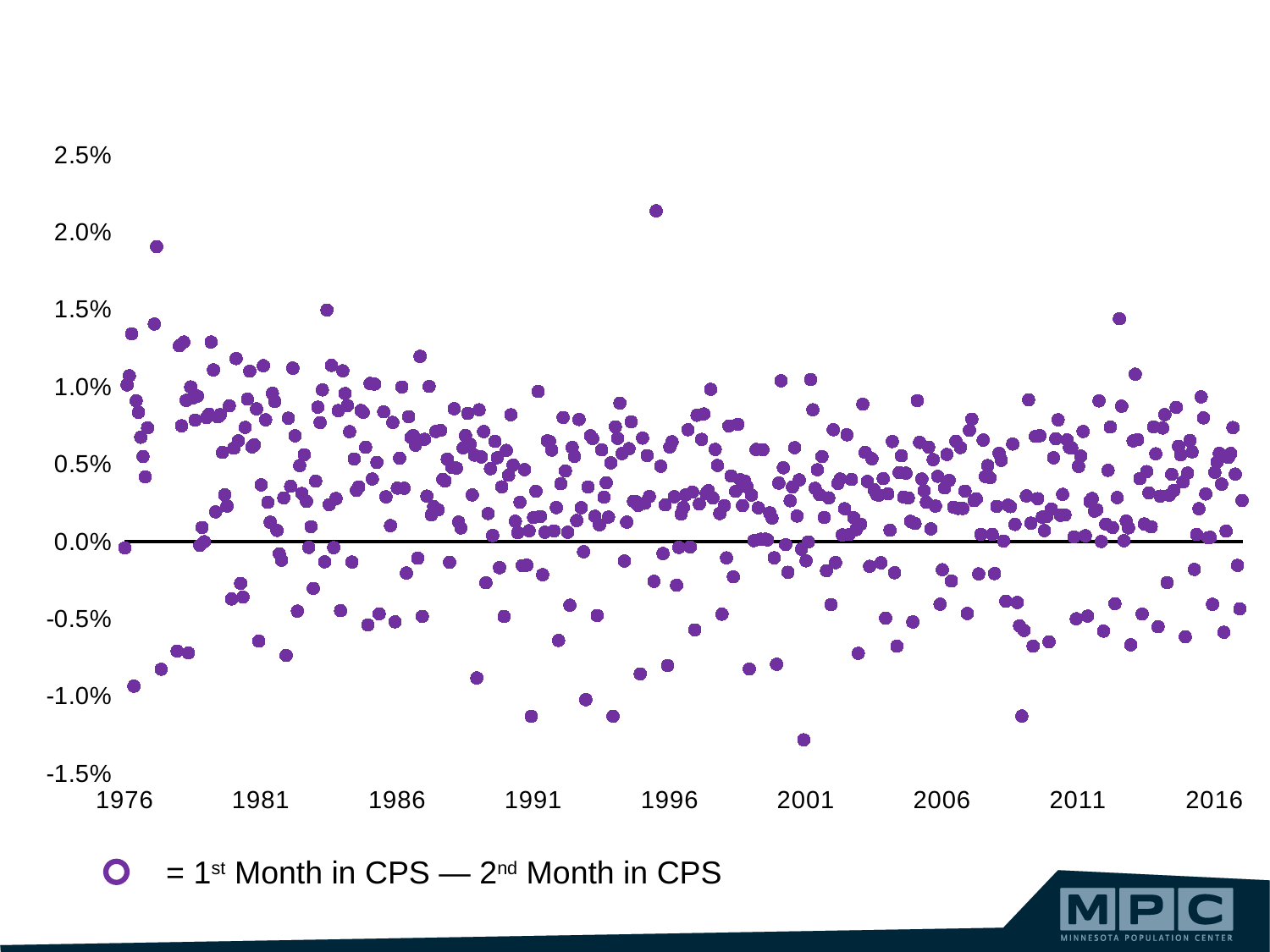
What are the first and last years labelled on the x axis? 1976 and 2016 Are most of the plotted points above or below the 0.0% line? above Is the low point near 2009 greater or less than -1.0%? less Is the low point near 1991 greater or less than -1.0%? less Is the highest point near 1995 higher or lower than the high point near 1977? higher Is the high point near 1977 greater or less than 1.5%? greater What does the legend say the plotted points represent? 1st Month in CPS — 2nd Month in CPS What kind of chart is shown on the slide? scatter plot How many series does the legend list? 1